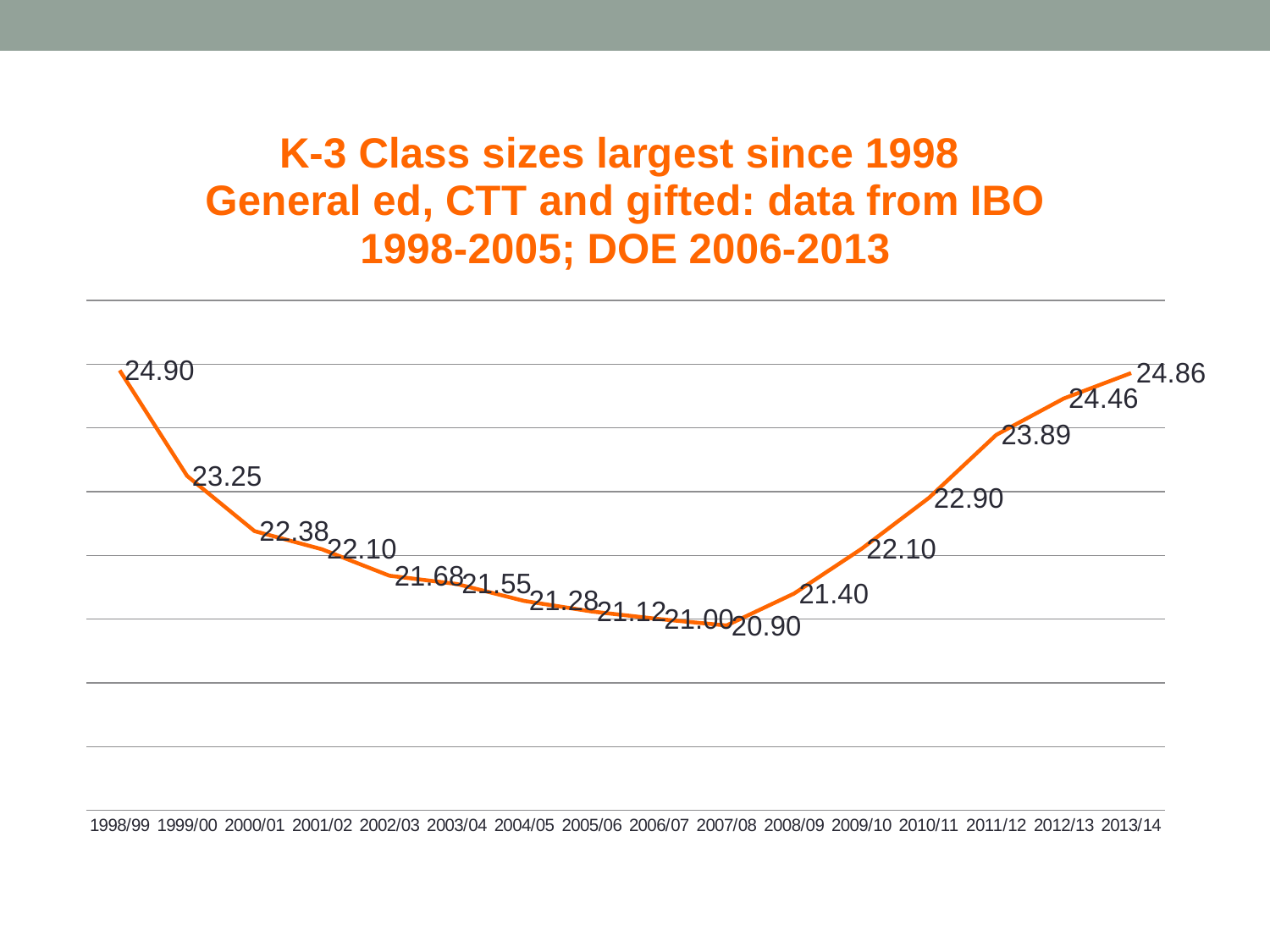
What is the value for 2013/14? 24.86 What is the difference between the values for 1998/99 and 1999/00? 1.65 What kind of chart is shown? Line chart Do the values rise or fall from 2007/08 to 2013/14? Rise Which is larger, the value for 2011/12 or the value for 2009/10? 2011/12 What is the value for 2007/08? 20.90 Which year has the highest value? 1998/99 Which year has the lowest value? 2007/08 What is the difference between the values for 2013/14 and 2007/08? 3.96 How many school years are plotted on the x axis? 16 What is the value for 2010/11? 22.90 What is the value for 1998/99? 24.90